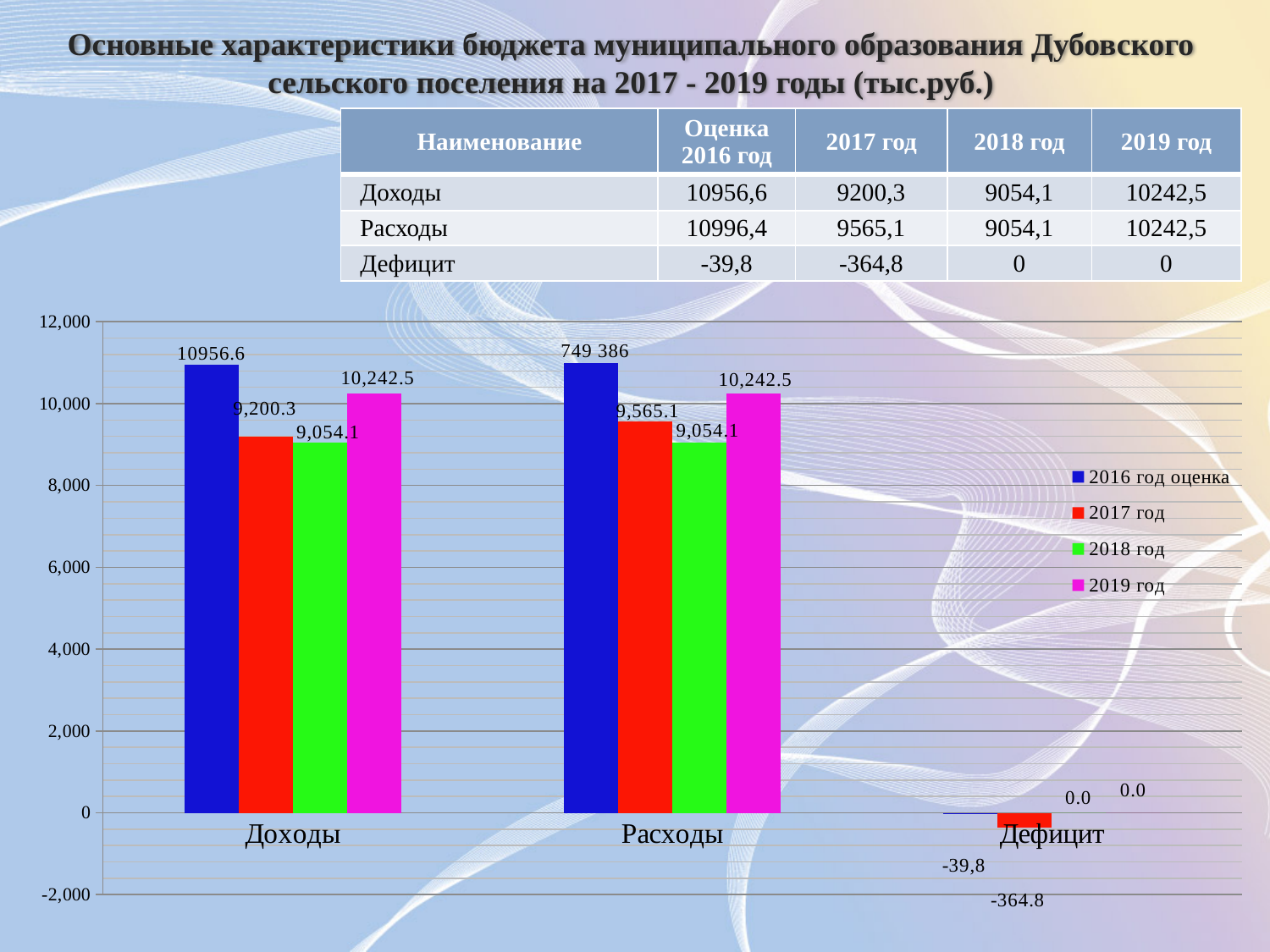
What kind of chart is shown on the slide? bar chart Is the value for Доходы in the 2019 год series greater or less than 10,000? greater What is the value for Расходы in the 2017 год series? 9,565.1 How many categories are shown on the x axis of the chart? 3 How many series does the chart legend list? 4 What is the value for Доходы in the 2017 год series? 9,200.3 What is the value for Доходы in the 2016 год оценка series? 10956.6 Which series has the lowest value for Доходы? 2018 год What is the value for Расходы in the 2019 год series? 10,242.5 What is the value for Дефицит in the 2017 год series? -364.8 Which is larger for the 2017 год series: Доходы or Расходы? Расходы What is the difference between the 2019 год and 2018 год values for Доходы? 1,188.4